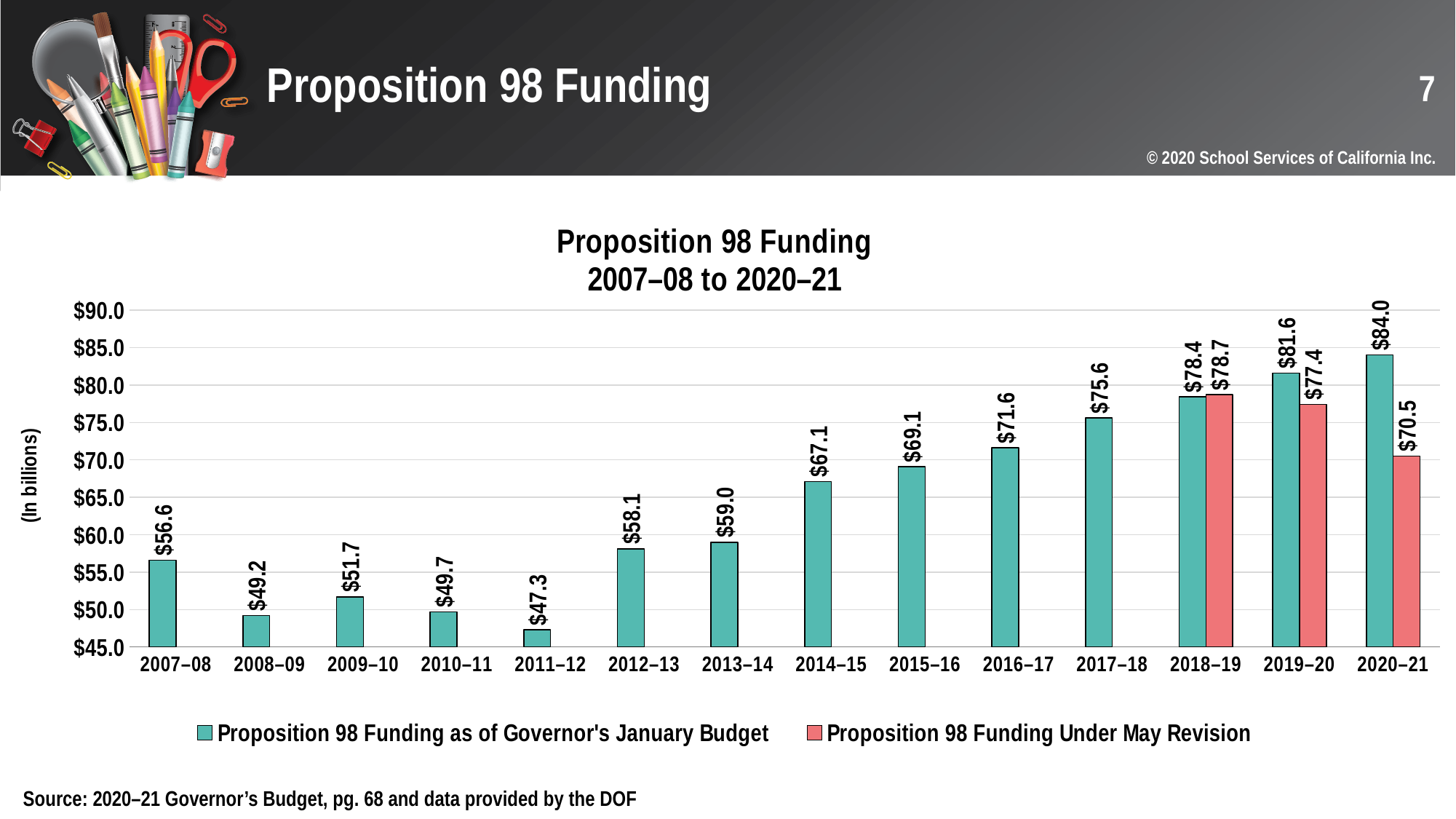
How many series does the legend list? 2 What is the Proposition 98 Funding as of Governor's January Budget for 2014–15? $67.1 What unit is indicated on the y axis label? In billions What is the difference between the January Budget value and the May Revision value for 2020–21? $13.5 Which year has the lowest Proposition 98 Funding as of Governor's January Budget? 2011–12 What kind of chart is shown on the slide? Bar chart What is the Proposition 98 Funding Under May Revision for 2020–21? $70.5 Which year has the highest Proposition 98 Funding as of Governor's January Budget? 2020–21 Is the Proposition 98 Funding as of Governor's January Budget for 2016–17 greater or less than $70.0? greater What is the Proposition 98 Funding as of Governor's January Budget for 2007–08? $56.6 How many fiscal years are shown on the x axis? 14 For 2018–19, which is larger: the January Budget value or the May Revision value? May Revision ($78.7)